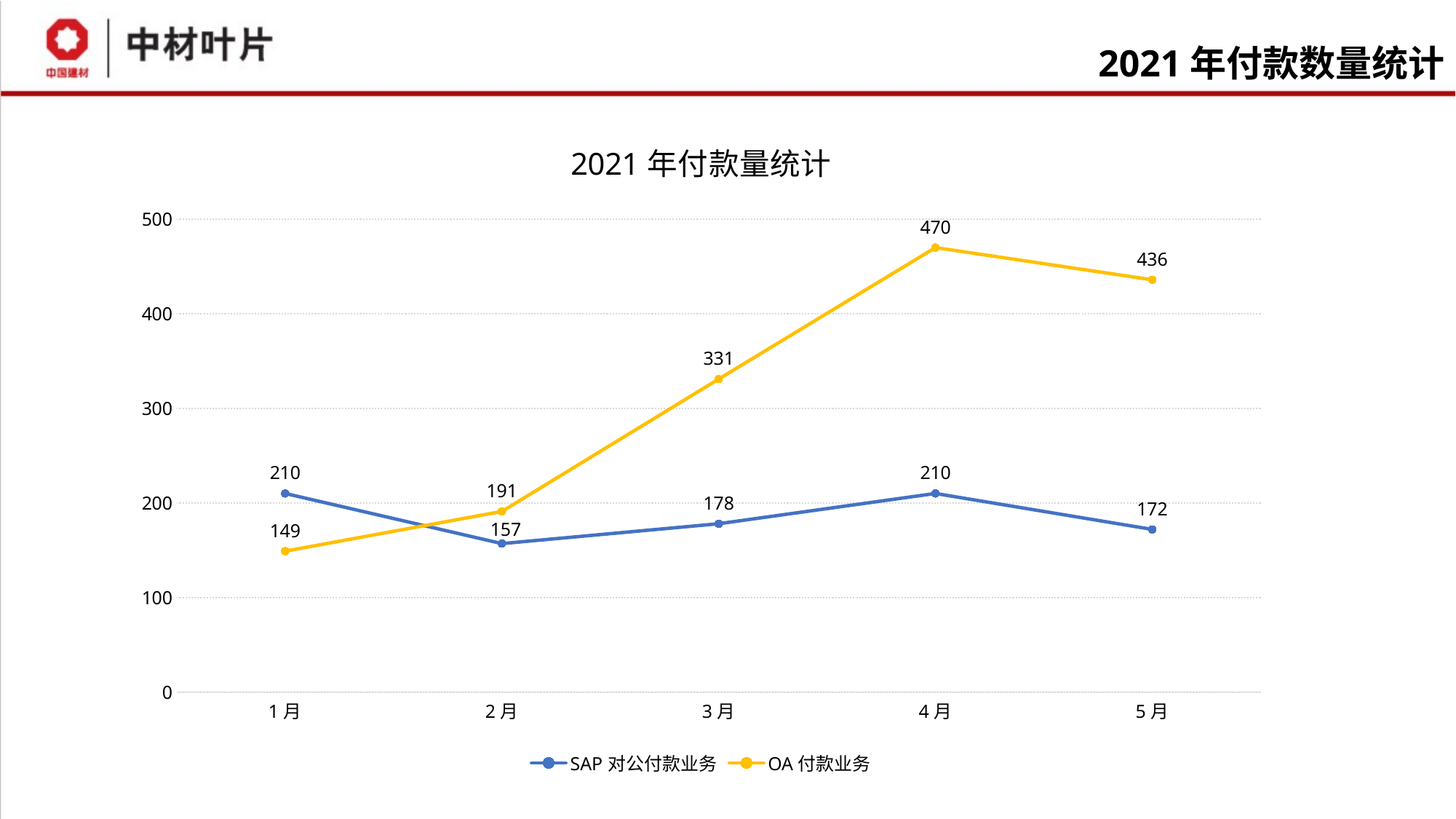
How many series does the legend list? 2 In which month is OA 付款业务 highest? 4月 What kind of chart is shown on the slide? Line chart In which month is SAP 对公付款业务 lowest? 2月 How many months are shown on the x axis? 5 Does OA 付款业务 rise or fall from 1月 to 4月? Rise What is the value for OA 付款业务 in 4月? 470 What is the value for SAP 对公付款业务 in 2月? 157 What is the difference between OA 付款业务 and SAP 对公付款业务 in 5月? 264 What is the value for OA 付款业务 in 1月? 149 Which series has the larger value in 1月, SAP 对公付款业务 or OA 付款业务? SAP 对公付款业务 What is the title of the chart? 2021 年付款量统计